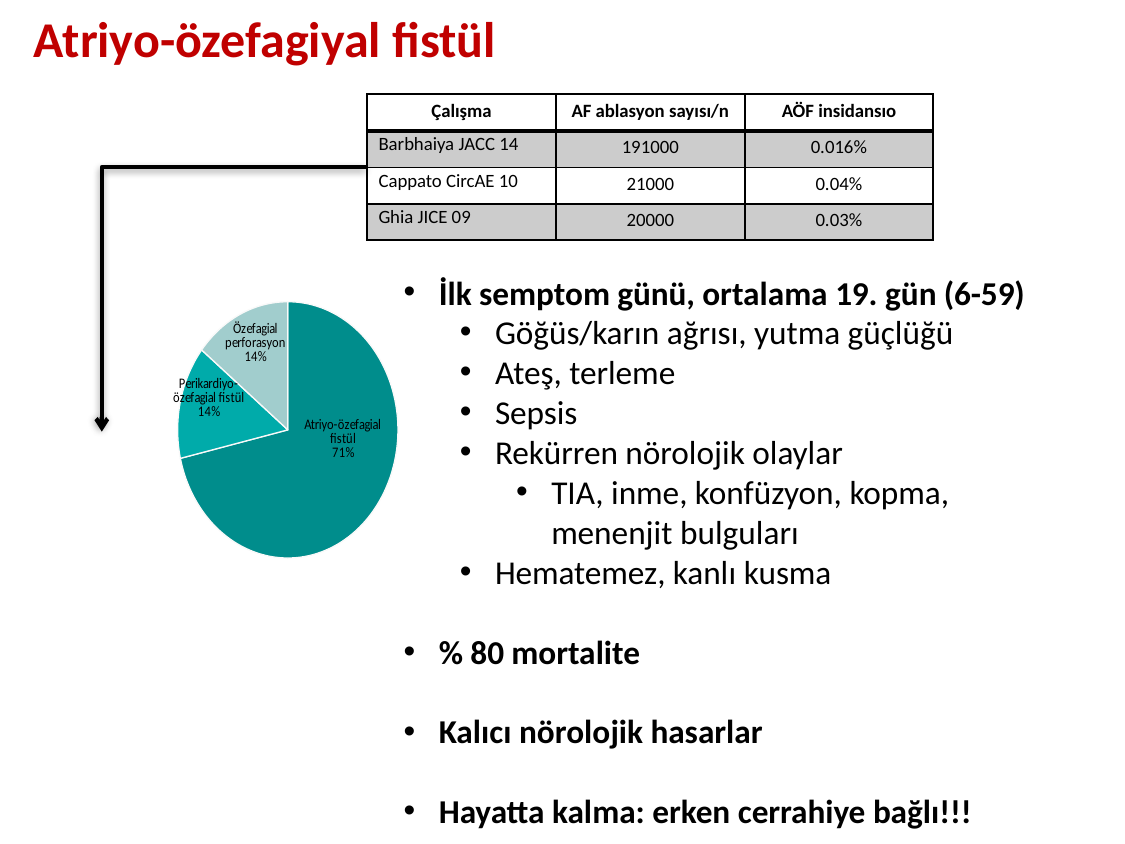
What share of the pie does Özefagial perforasyon represent? 14% What is the difference in percentage points between the Atriyo-özefagial fistül slice and the Özefagial perforasyon slice? 57 Which slice of the pie chart is the largest? Atriyo-özefagial fistül Is the share for Atriyo-özefagial fistül greater or less than 50%? greater What is the combined share of the Perikardiyo-özefagial fistül and Özefagial perforasyon slices? 28% Which slice of the pie chart is drawn in the darkest teal colour? Atriyo-özefagial fistül How many slices does the pie chart have? 3 What share of the pie does Atriyo-özefagial fistül represent? 71% Do the Perikardiyo-özefagial fistül and Özefagial perforasyon slices have the same share? Yes, both 14% What share of the pie does Perikardiyo-özefagial fistül represent? 14% Which is larger in the pie chart: Atriyo-özefagial fistül or Perikardiyo-özefagial fistül? Atriyo-özefagial fistül What kind of chart is shown on the slide? pie chart